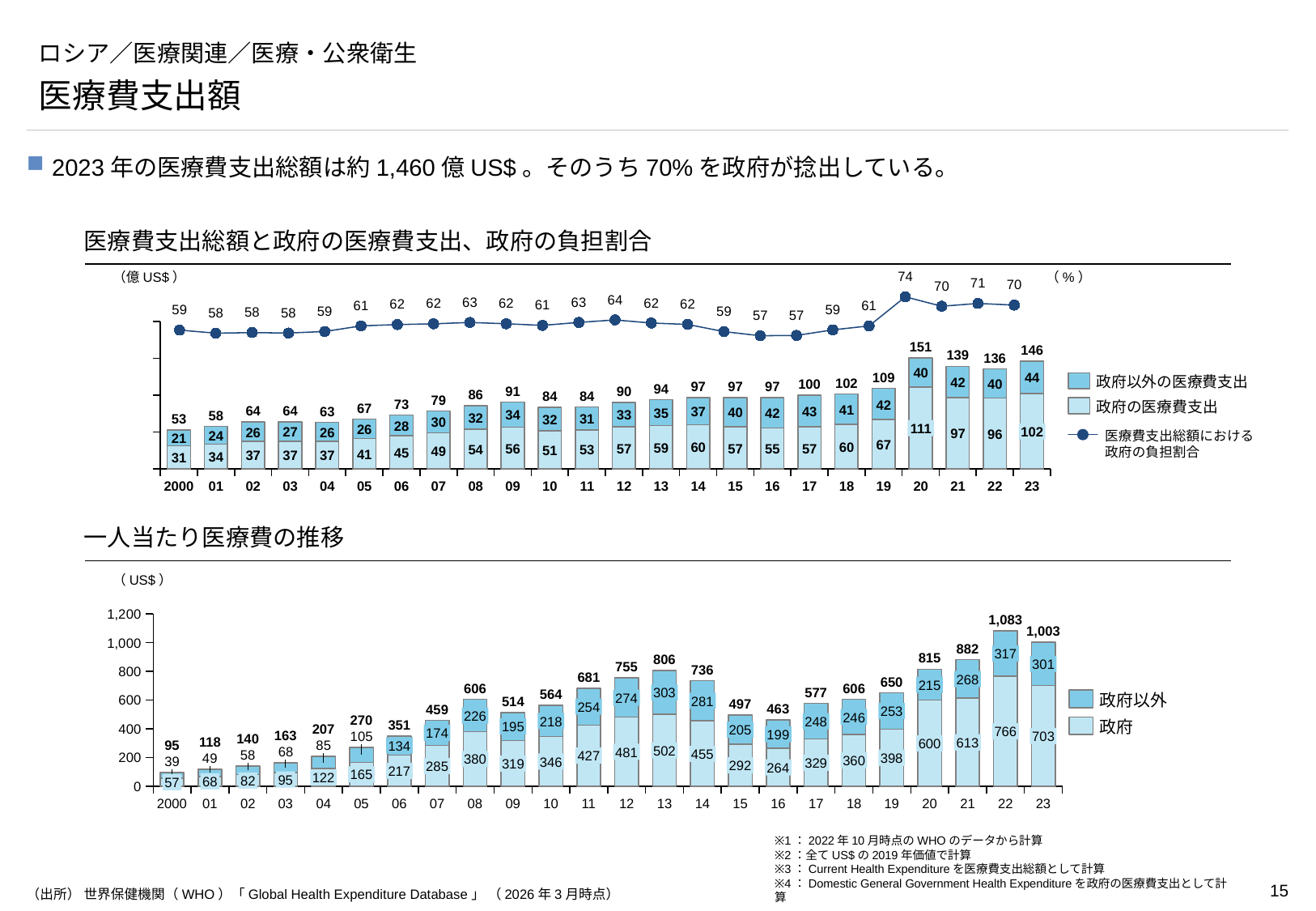
What kind of chart is the bottom chart (一人当たり医療費の推移)? Stacked bar chart In the bottom chart, how many years are shown on the x axis? 24 In the top chart, which year has the lowest total health expenditure bar? 2000 In the bottom chart, what is the government (政府) per-capita value for 2023? 703 In the bottom chart, which year has the highest total per-capita health expenditure? 2022 In the bottom chart, is the total per-capita value for 2013 greater or less than 800? greater In the top chart, what is the government's share of total health expenditure (政府の負担割合) in 2020? 74 In the top chart, how many entries does the legend list? 3 In the top chart, what is the difference between the government health expenditure (政府の医療費支出) in 2020 and in 2023? 9 In the bottom chart (一人当たり医療費の推移), what is the total per-capita health expenditure for 2022? 1,083 In the top chart (医療費支出総額と政府の医療費支出、政府の負担割合), what is the total health expenditure for 2023? 146 In the top chart, which year has the highest total health expenditure bar? 2020